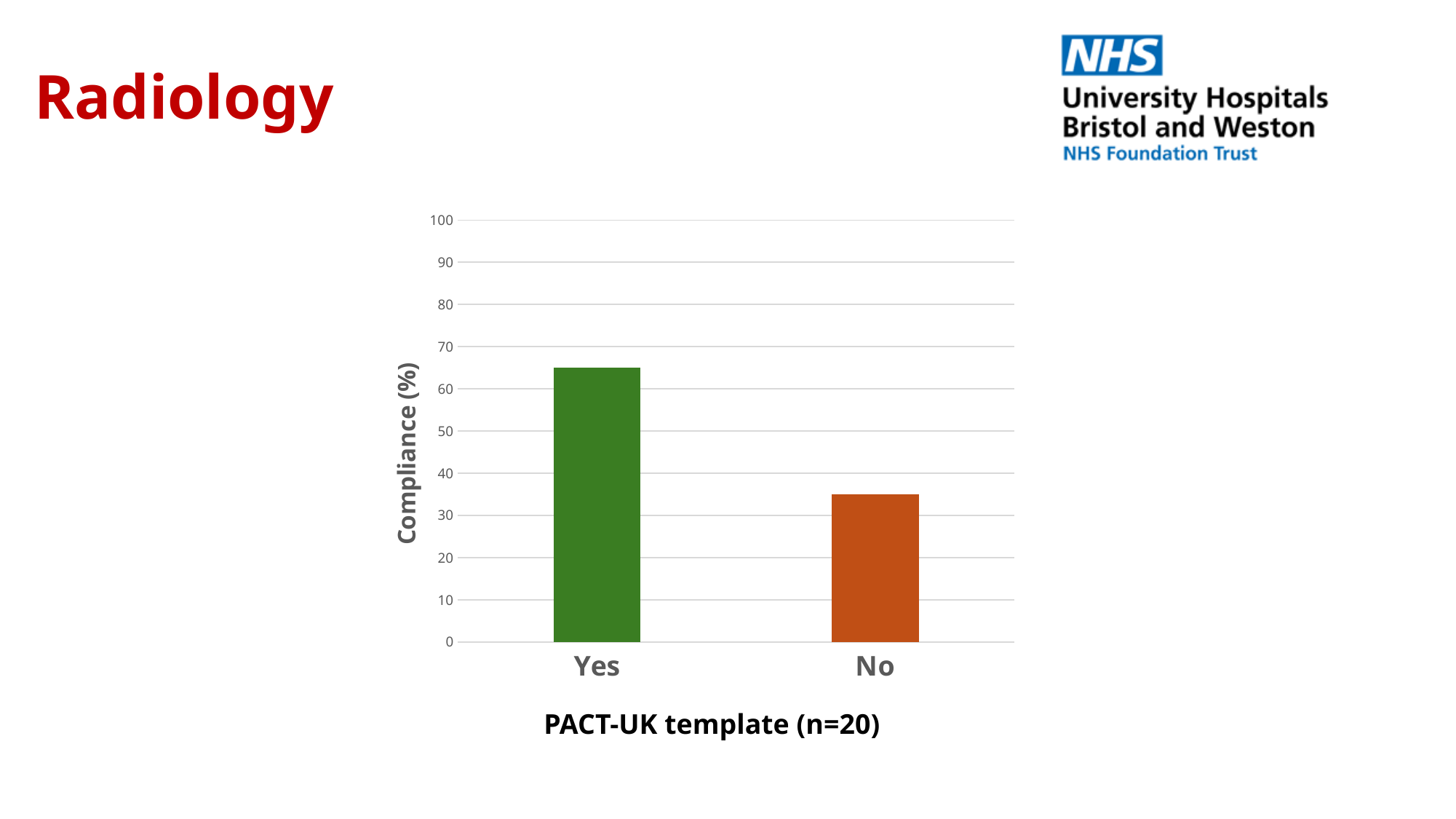
Is the value for Yes greater or less than 60? greater Is the value for No greater or less than 30? greater What is the label of the x axis of the chart? PACT-UK template (n=20) What is the label of the y axis of the chart? Compliance (%) What kind of chart is shown on the slide? bar chart How many categories are shown on the x axis of the chart? 2 Do the values fall or rise from the Yes bar to the No bar? fall Which category has the lowest compliance in the chart? No Which category has the highest compliance in the chart? Yes Which is larger, the value for Yes or the value for No? Yes Is the value for No greater or less than 40? less